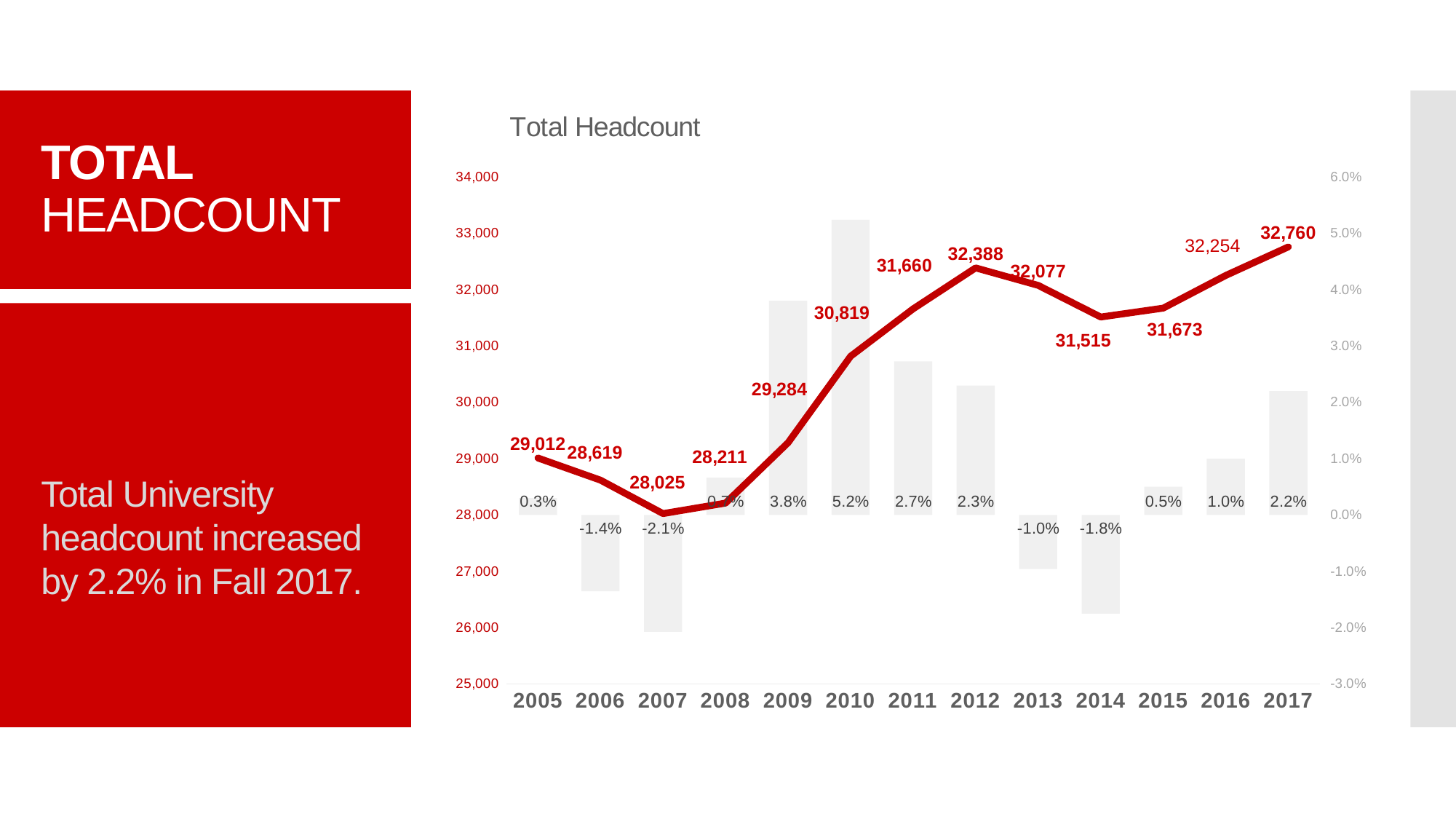
What is the title of the chart? Total Headcount What is the total headcount for 2010? 30,819 Which is larger, the total headcount in 2012 or in 2013? 2012 What is the difference in total headcount between 2017 and 2016? 506 Which year shows the largest percentage change? 2010 What is the percentage change shown for 2014? -1.8% What kind of chart is used to show the total headcount values? Line chart (with bars for percentage change) What is the total headcount for 2017? 32,760 Which year has the lowest total headcount? 2007 Does the total headcount rise or fall from 2007 to 2012? Rise How many years are shown on the x axis? 13 Which year has the highest total headcount? 2017